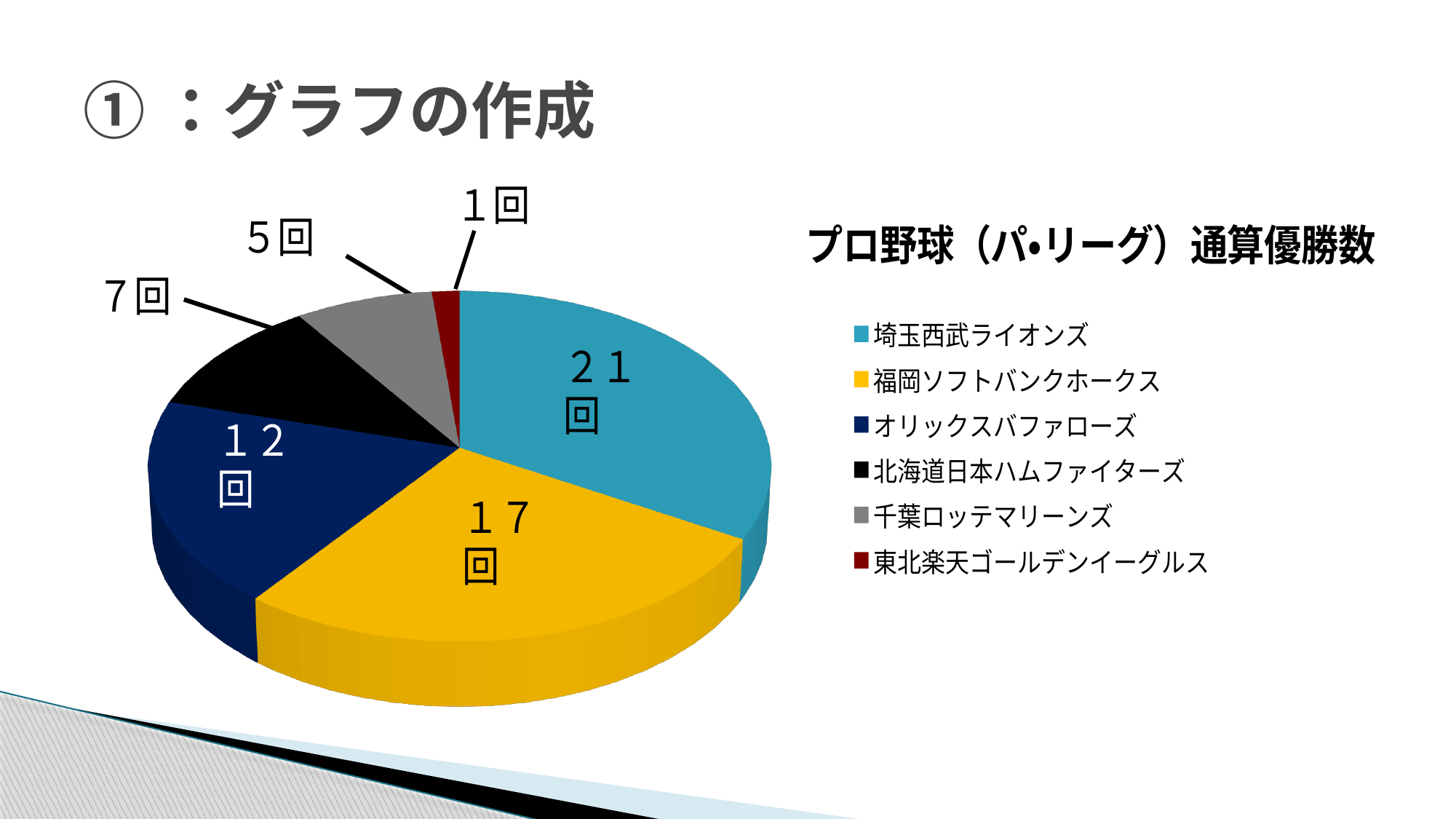
What is the difference between the values for 埼玉西武ライオンズ and 福岡ソフトバンクホークス? 4回 Which is larger, the value for 北海道日本ハムファイターズ or 千葉ロッテマリーンズ? 北海道日本ハムファイターズ What kind of chart is shown on the slide? pie chart How many entries does the legend list? 6 What is the value shown for 東北楽天ゴールデンイーグルス? 1回 What is the value shown for オリックスバファローズ? 12回 What is the title of the chart? プロ野球（パ・リーグ）通算優勝数 What is the value shown for 埼玉西武ライオンズ? 21回 How many teams (slices) does the pie chart show? 6 Which team has the largest slice of the pie? 埼玉西武ライオンズ Which team has the smallest slice of the pie? 東北楽天ゴールデンイーグルス What is the value shown for 福岡ソフトバンクホークス? 17回